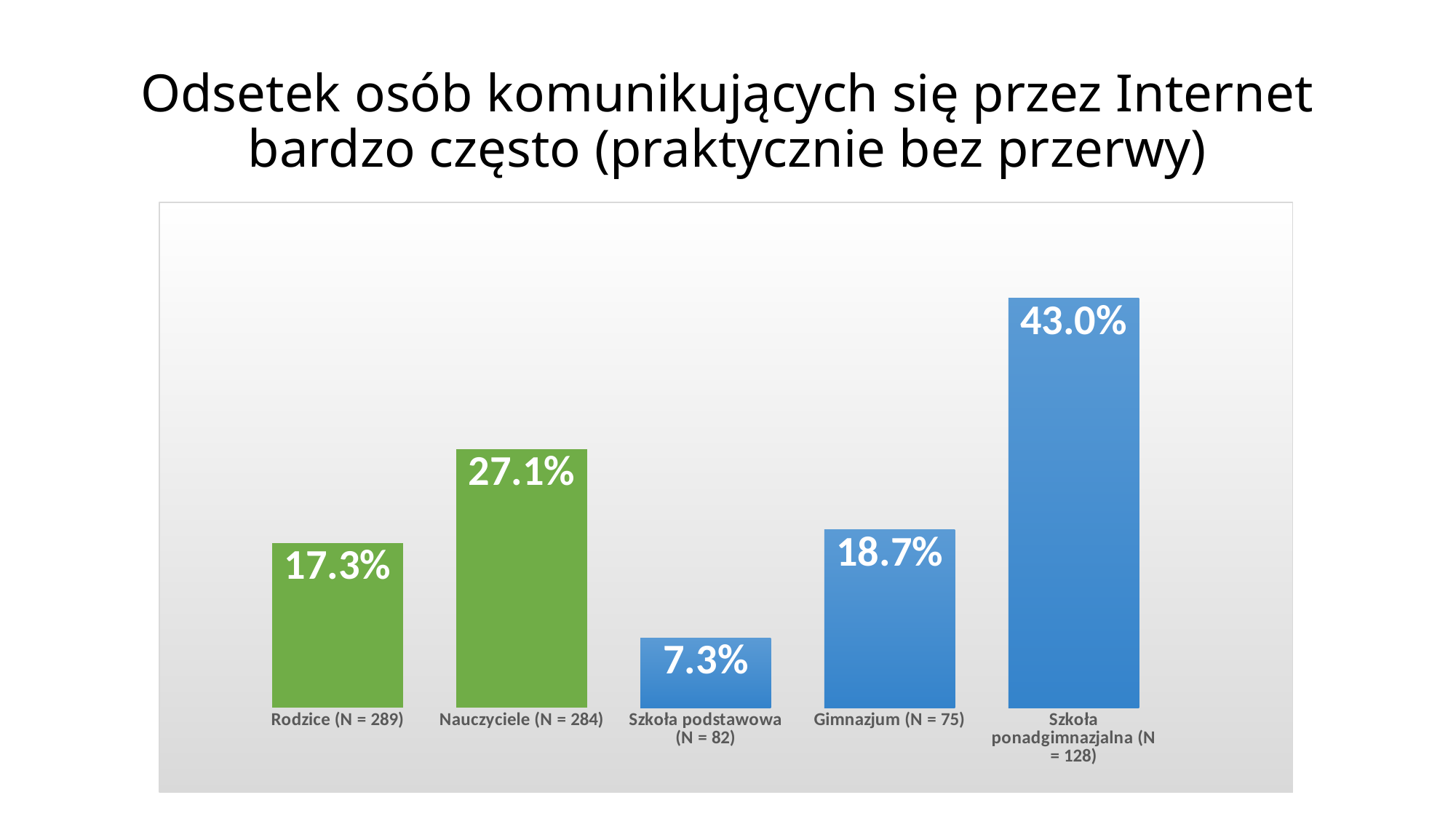
Which is larger, the value for Gimnazjum (N = 75) or the value for Rodzice (N = 289)? Gimnazjum (N = 75) Which category has the highest value? Szkoła ponadgimnazjalna (N = 128) How many categories are shown in the chart? 5 What is the value for Nauczyciele (N = 284)? 27.1% What colour are the bars for Rodzice and Nauczyciele? Green What is the value for Szkoła podstawowa (N = 82)? 7.3% Which category has the lowest value? Szkoła podstawowa (N = 82) What is the value for Szkoła ponadgimnazjalna (N = 128)? 43.0% What is the difference between the values for Szkoła ponadgimnazjalna (N = 128) and Nauczyciele (N = 284)? 15.9% What is the value for Gimnazjum (N = 75)? 18.7% What kind of chart is shown on the slide? Bar chart What is the value for Rodzice (N = 289)? 17.3%